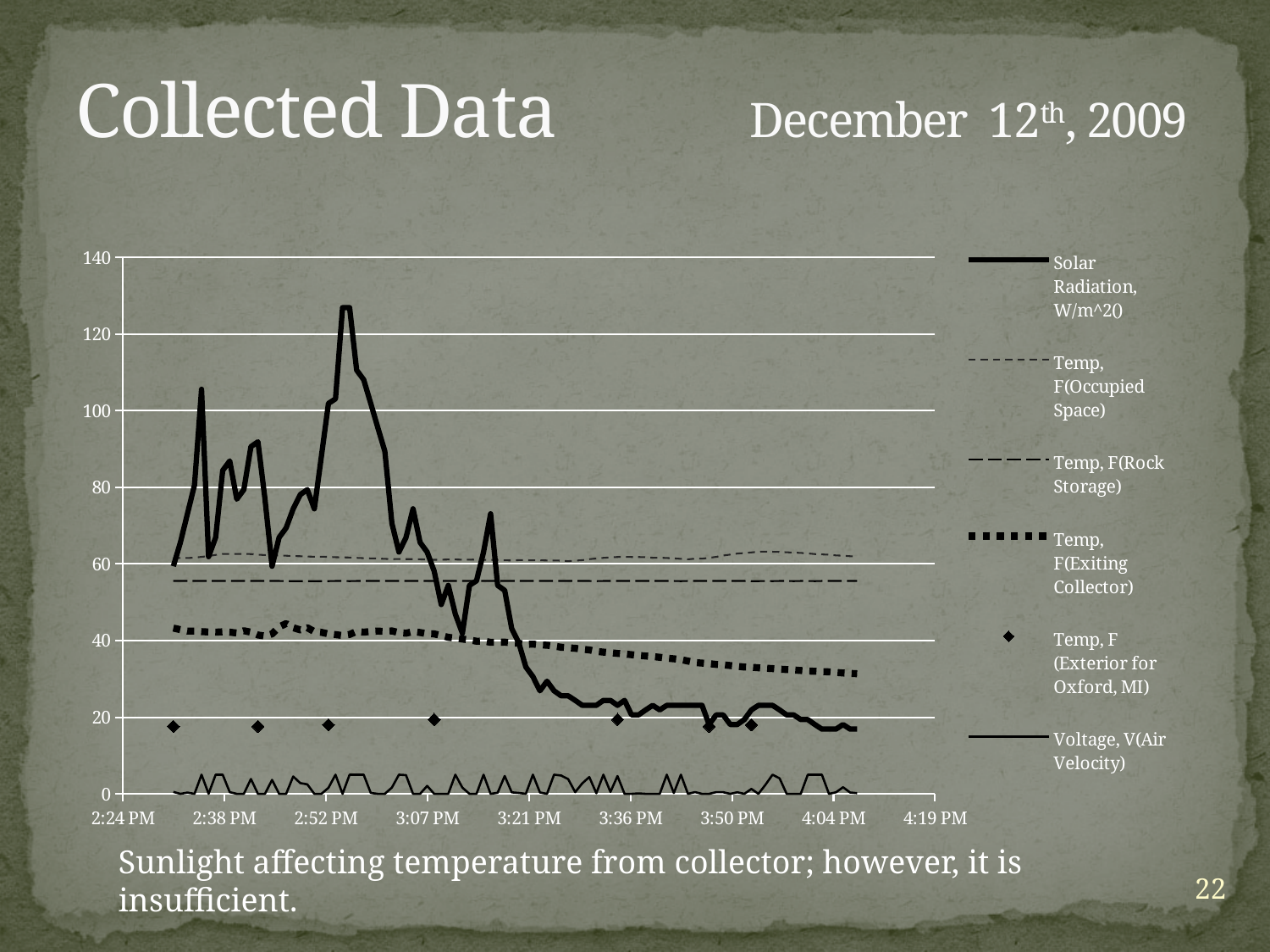
Is the value of Temp, F(Occupied Space) greater or less than 80? less Are the Voltage, V(Air Velocity) values greater or less than 20? less Is the value of Temp, F(Rock Storage) greater or less than 60? less Which is higher on the chart, Temp, F(Occupied Space) or Temp, F(Rock Storage)? Temp, F(Occupied Space) Does the Temp, F(Exiting Collector) series rise or fall from 3:21 PM to 4:04 PM? fall Which series is drawn with diamond markers? Temp, F (Exterior for Oxford, MI) How many series does the legend list? 6 What kind of chart is shown on the slide? line chart Does the Solar Radiation, W/m^2() series rise or fall from 3:07 PM to 4:04 PM? fall Which series reaches the highest value on the chart? Solar Radiation, W/m^2()